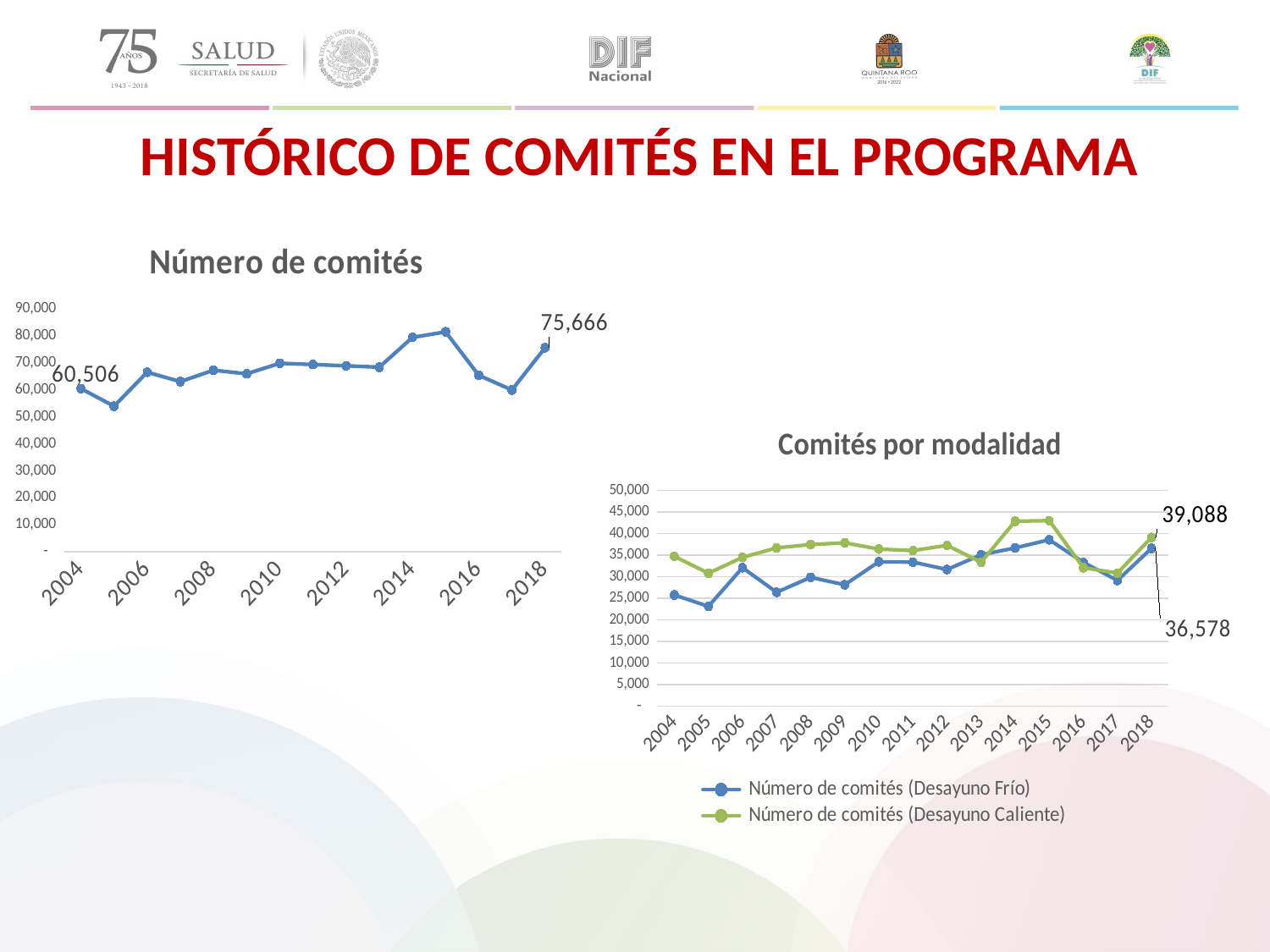
In the "Comités por modalidad" chart, what is the difference between the Desayuno Caliente and Desayuno Frío values in 2018? 2,510 In the "Número de comités" chart, what is the value for 2004? 60,506 In the "Número de comités" chart, is the value for 2005 greater or less than 60,000? less In the "Comités por modalidad" chart, what is the 2018 value for Número de comités (Desayuno Frío)? 36,578 In the "Número de comités" chart, which year has the highest value? 2015 In the "Número de comités" chart, what is the difference between the 2018 value and the 2004 value? 15,160 In the "Número de comités" chart, which year has the lowest value? 2005 What kind of chart is the "Número de comités" chart? line chart In the "Número de comités" chart, what is the value for 2018? 75,666 How many series does the legend of the "Comités por modalidad" chart list? 2 In the "Comités por modalidad" chart, which colour is used for the Número de comités (Desayuno Frío) series? blue In the "Comités por modalidad" chart, what is the 2018 value for Número de comités (Desayuno Caliente)? 39,088